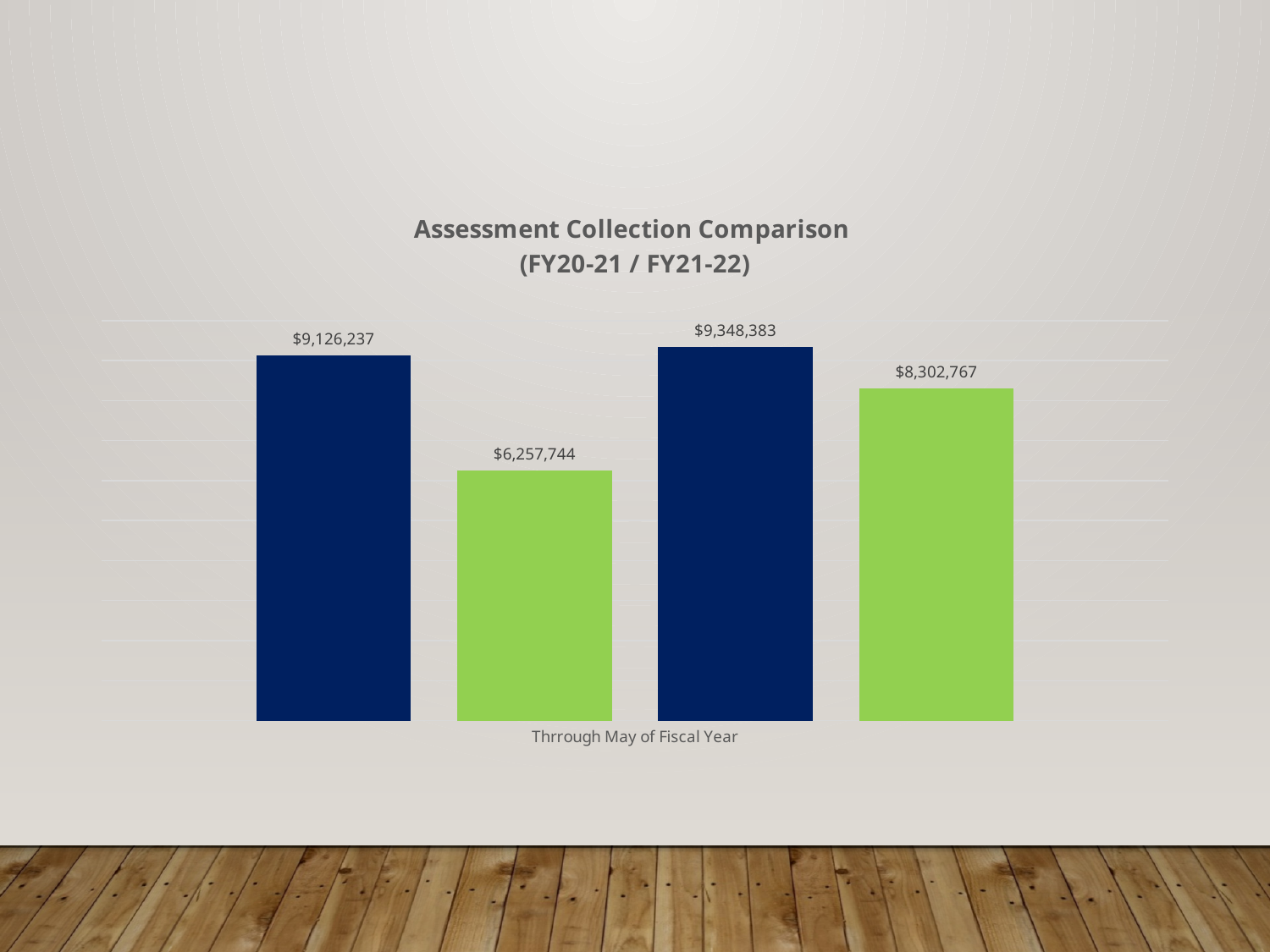
How many bars are plotted in the chart? 4 What is the title of the chart? Assessment Collection Comparison (FY20-21 / FY21-22) What is the value shown on the fourth (rightmost) bar? $8,302,767 What is the value shown on the first (leftmost) bar? $9,126,237 What is the value shown on the third bar from the left? $9,348,383 What text appears below the bars as the horizontal axis label? Thrrough May of Fiscal Year What kind of chart is shown on the slide? bar chart What is the value shown on the second bar from the left? $6,257,744 Which is larger, the first bar ($9,126,237) or the third bar ($9,348,383)? the third bar ($9,348,383) Which bar has the lowest value? the second bar ($6,257,744) What is the difference between the two green bars, $8,302,767 and $6,257,744? $2,045,023 Which bar has the highest value? the third bar ($9,348,383)